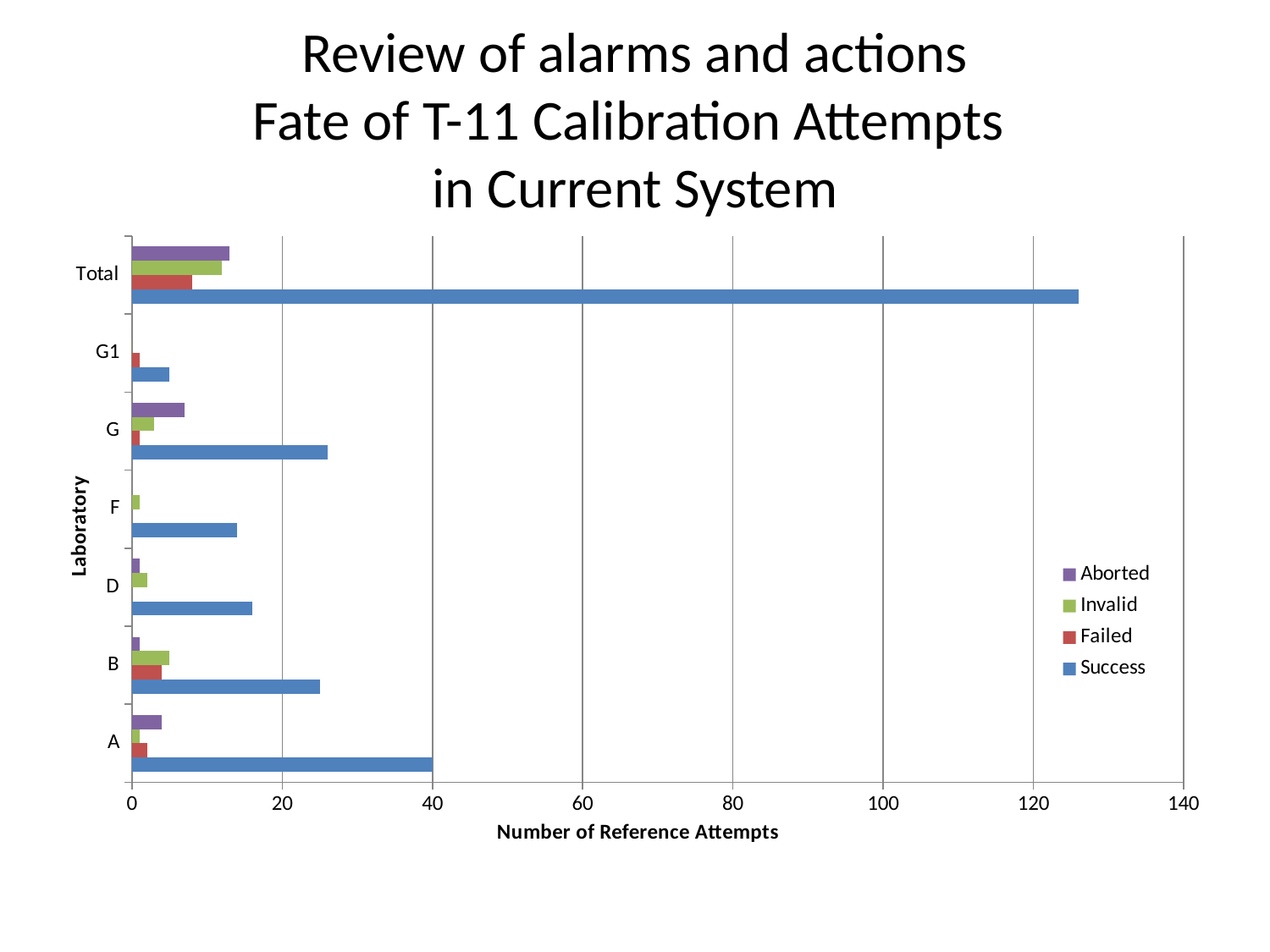
Is the Success value for Total greater or less than 120? greater Which has the larger Success value, A or B? A How many series does the legend list? 4 What kind of chart is shown on the slide? bar chart Is the Success value for D greater or less than 20? less Among the individual laboratories (excluding Total), which has the highest Success value? A Which category has the longest Success bar? Total Which has the larger Success value, G or D? G Among the individual laboratories (excluding Total), which has the lowest Success value? G1 Is the Success value for G greater or less than 20? greater What is the title of the horizontal axis? Number of Reference Attempts How many categories are shown on the Laboratory axis? 7